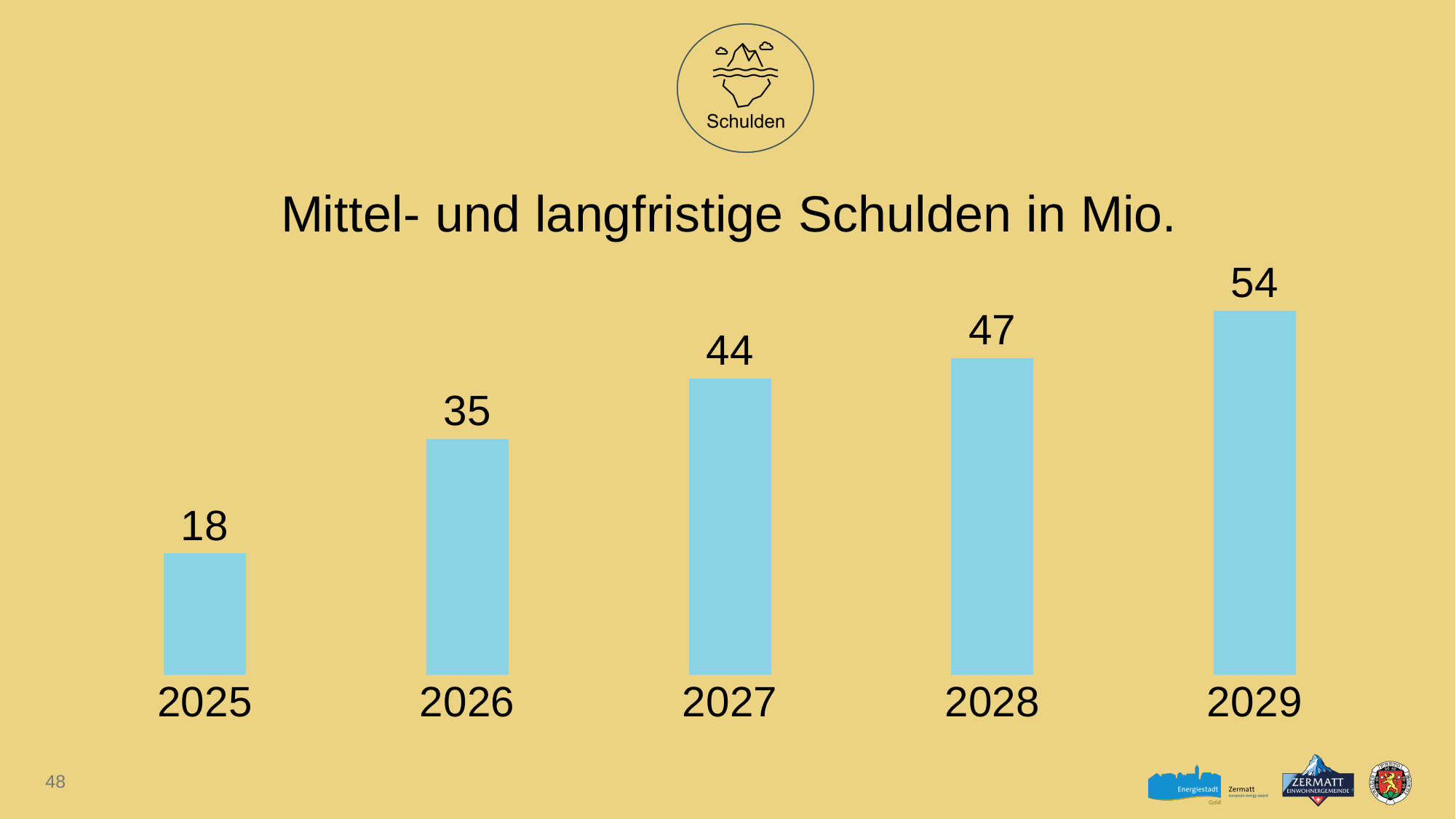
What is the value for 2027? 44 What is the difference between the values for 2029 and 2025? 36 Which year has the lowest value? 2025 What is the title of the chart? Mittel- und langfristige Schulden in Mio. What is the value for 2025? 18 What is the value for 2029? 54 What is the difference between the values for 2026 and 2025? 17 Do the values rise or fall from 2025 to 2029? rise How many years are shown on the chart? 5 Which is larger, the value for 2027 or the value for 2028? 2028 Which year has the highest value? 2029 What kind of chart is this? bar chart